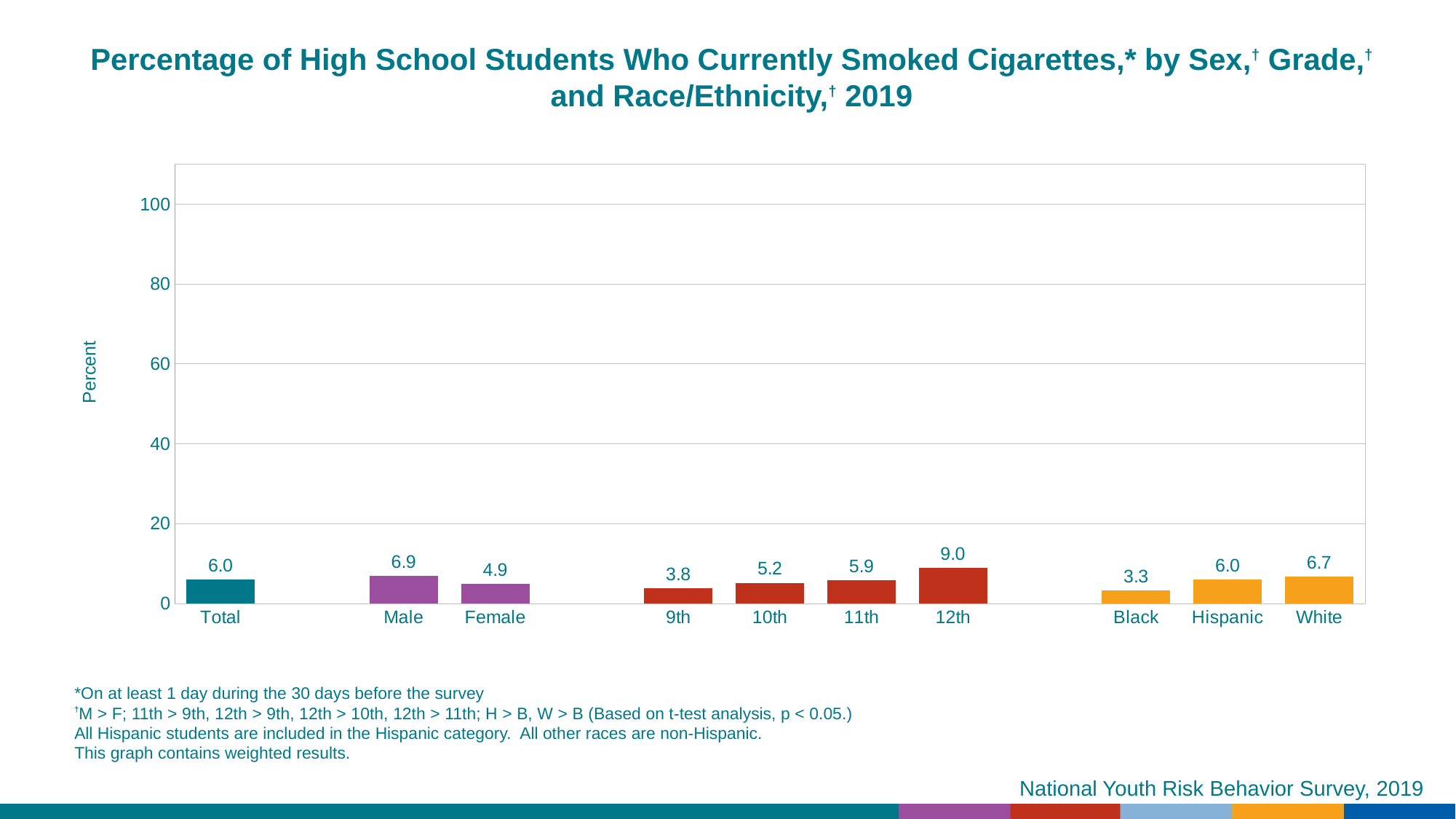
How many categories are shown on the x axis? 10 What kind of chart is this? bar chart Which category has the highest value? 12th Is the value for 12th grade greater or less than 20? less What is the value for 9th grade? 3.8 What is the difference between the values for Male and Female? 2.0 What is the difference between the values for 12th and 9th grade? 5.2 Do the values rise or fall across the grade categories from 9th to 12th? rise What is the value for Black students? 3.3 Which is larger, the value for White or the value for Hispanic? White What is the value for Male? 6.9 Which category has the lowest value? Black